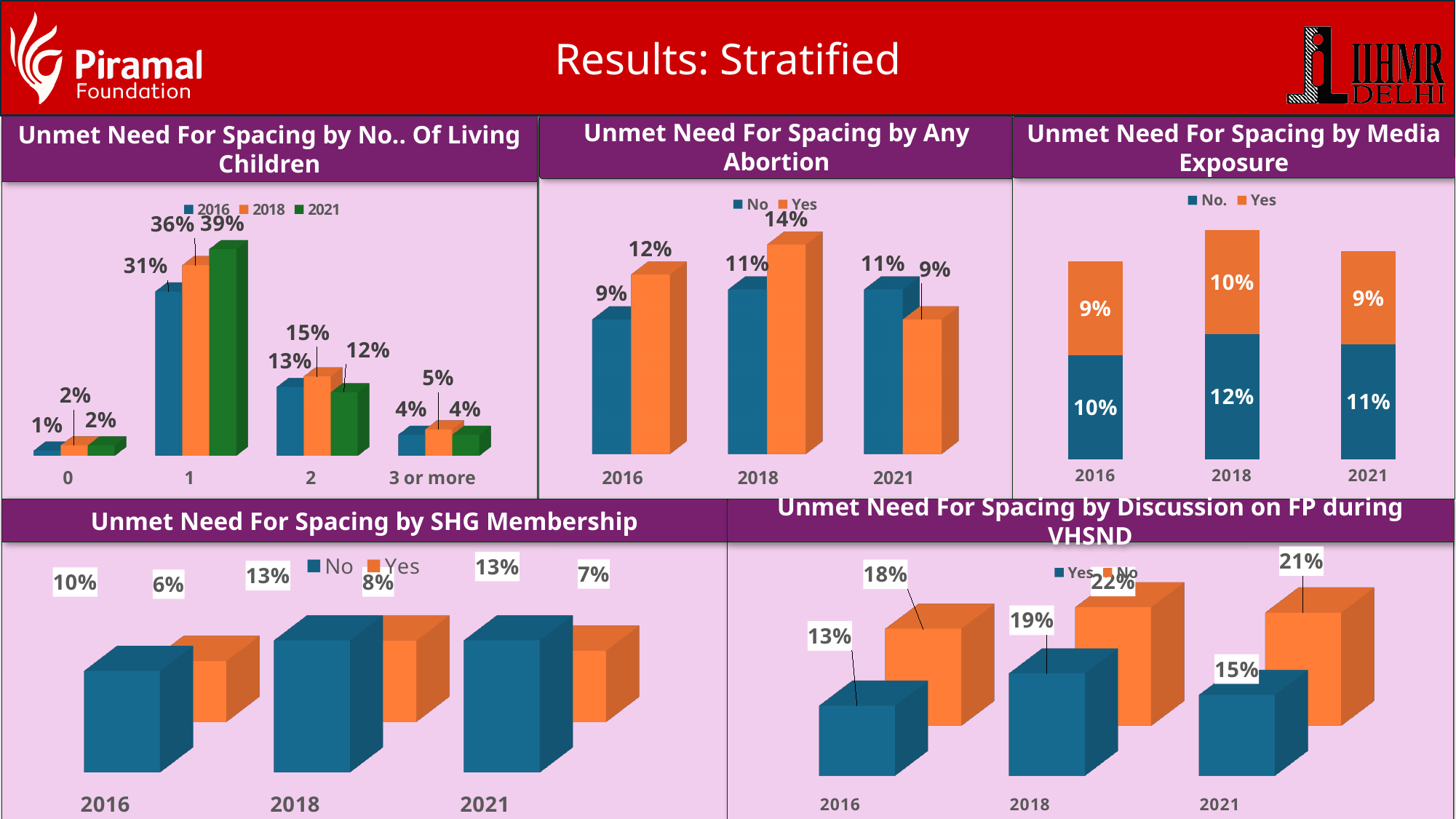
In the 'Unmet Need For Spacing by SHG Membership' chart, how many year categories are shown on the x axis? 3 In the 'Unmet Need For Spacing by No.. Of Living Children' chart, how many series does the legend list? 3 In the 'Unmet Need For Spacing by Any Abortion' chart, which is larger in 2021, No or Yes? No In the 'Unmet Need For Spacing by Any Abortion' chart, what is the value for Yes in 2018? 14% In the 'Unmet Need For Spacing by Media Exposure' chart, what is the total of the stacked bar for 2018? 22% In the 'Unmet Need For Spacing by No.. Of Living Children' chart, what is the value for 1 living child in 2021? 39% In the 'Unmet Need For Spacing by No.. Of Living Children' chart, which category has the highest values across all years? 1 In the 'Unmet Need For Spacing by Any Abortion' chart, what is the difference between Yes and No in 2016? 3% In the 'Unmet Need For Spacing by Discussion on FP during VHSND' chart, what is the difference between No and Yes in 2021? 6% In the 'Unmet Need For Spacing by SHG Membership' chart, what is the value for Yes in 2016? 6% In the 'Unmet Need For Spacing by Discussion on FP during VHSND' chart, what is the value for No in 2018? 22% In the 'Unmet Need For Spacing by Media Exposure' chart, what is the value for No. in 2021? 11%